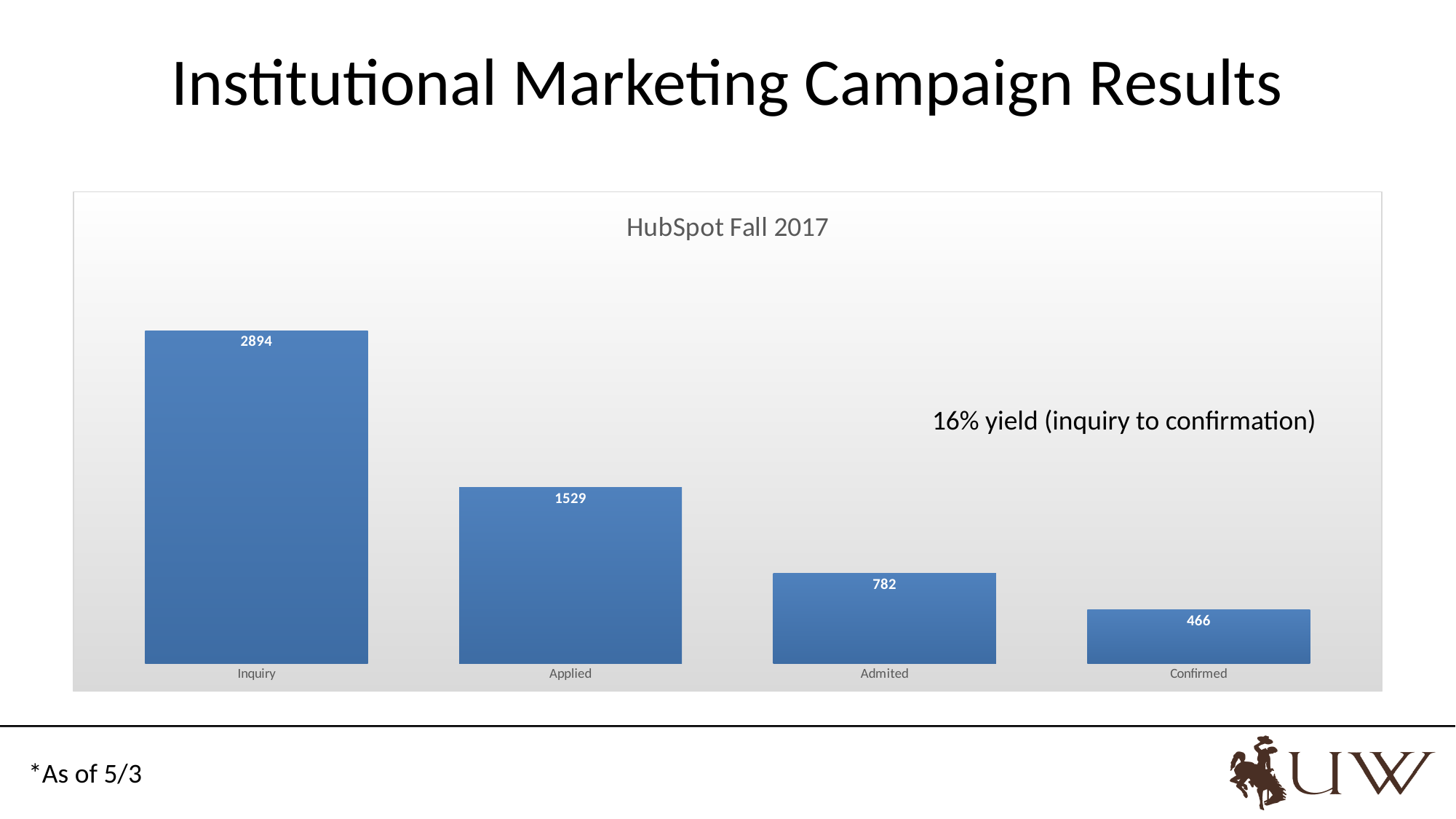
Which is larger, the value for Applied or the value for Admited? Applied What is the value for Confirmed? 466 Do the values rise or fall from Inquiry to Confirmed along the x axis? Fall What is the value for Inquiry? 2894 What is the difference between the Admited and Confirmed values? 316 What is the difference between the Inquiry and Applied values? 1365 What is the value for Applied? 1529 What kind of chart is shown on the slide? Bar chart Which category has the lowest value? Confirmed What is the value for Admited? 782 How many categories are shown on the x axis? 4 Which category has the highest value? Inquiry